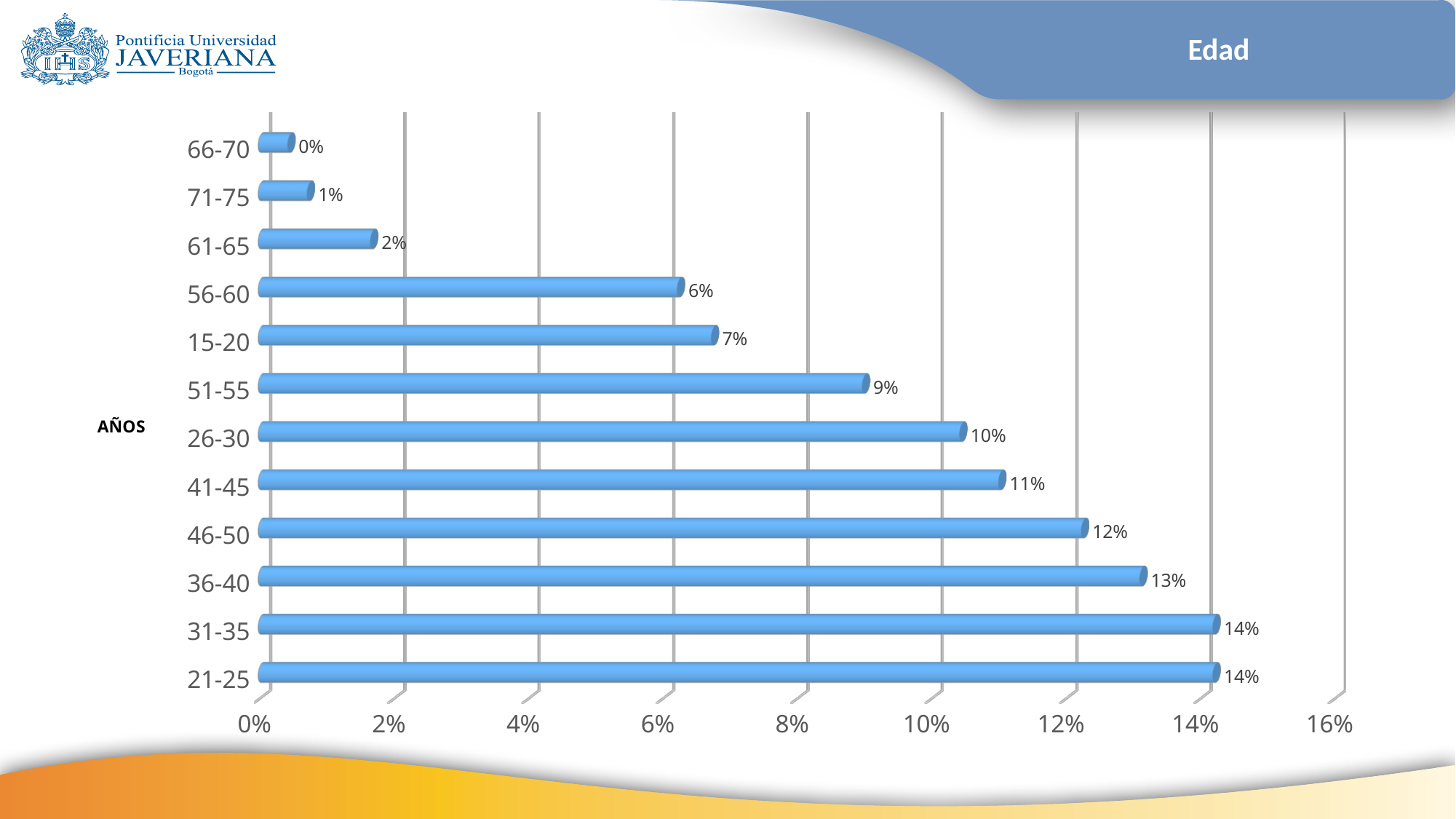
Which is larger, the value for 56-60 or the value for 15-20? 15-20 Which is larger, the value for 71-75 or the value for 61-65? 61-65 What kind of chart is shown on the slide? Bar chart How many age groups are shown in the chart? 12 What is the value for the 56-60 age group? 6% Which age group has the lowest value? 66-70 What is the title of the chart? Edad What is the difference between the values for 41-45 and 61-65? 9% What is the value for the 15-20 age group? 7% What is the value for the 46-50 age group? 12% What is the difference between the values for 36-40 and 51-55? 4% What is the value for the 26-30 age group? 10%